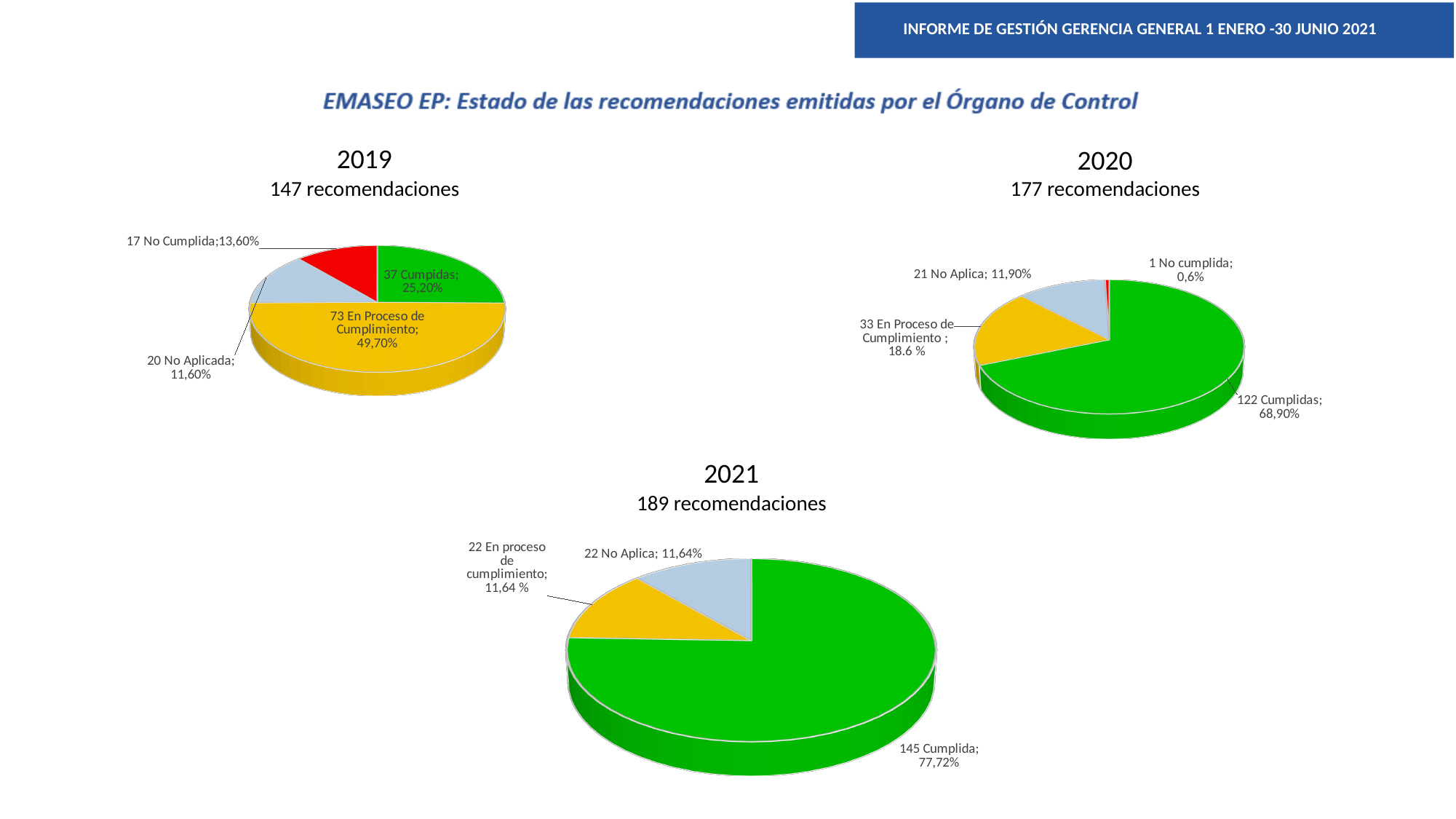
In the 2021 pie chart, what percentage share is shown for 'Cumplida'? 77,72% In the 2020 pie chart, what percentage share is shown for 'No Aplica'? 11,90% In the 2019 pie chart, what percentage share is shown for 'Cumpidas'? 25,20% In the 2020 pie chart, which category has the smallest slice? No cumplida In the 2019 pie chart, how many recommendations are labelled 'En Proceso de Cumplimiento'? 73 In the 2019 pie chart, how many slices are there? 4 How many total recommendations does the 2020 chart subtitle report? 177 recomendaciones In the 2021 pie chart, how many slices are there? 3 In the 2019 pie chart, which category has the largest slice? En Proceso de Cumplimiento In the 2020 pie chart, how many recommendations are labelled 'Cumplidas'? 122 What kind of chart is used for the 2021 data? Pie chart In the 2020 pie chart, what is the difference between the number of 'Cumplidas' and 'En Proceso de Cumplimiento' recommendations? 89